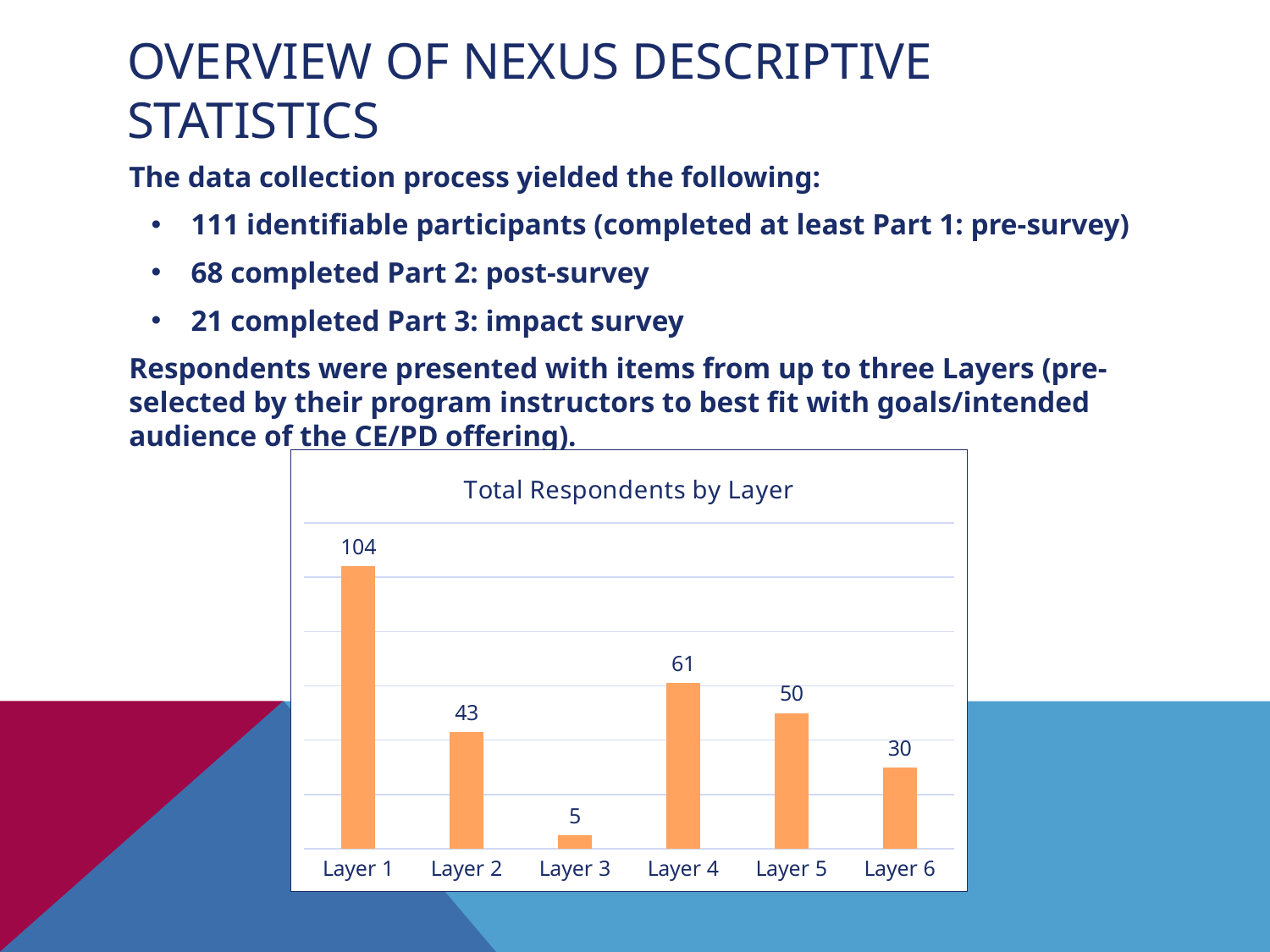
How many layers are shown in the chart? 6 Which layer has the lowest number of respondents? Layer 3 What is the difference between the values for Layer 1 and Layer 2? 61 What is the value for Layer 4 in the Total Respondents by Layer chart? 61 What is the value for Layer 1 in the Total Respondents by Layer chart? 104 Which layer has the highest number of respondents? Layer 1 What is the value for Layer 6 in the Total Respondents by Layer chart? 30 What is the title of the chart? Total Respondents by Layer What colour are the bars in the chart? Orange What is the difference between the values for Layer 4 and Layer 5? 11 Which has a larger value, Layer 2 or Layer 5? Layer 5 What kind of chart is shown on the slide? Bar chart